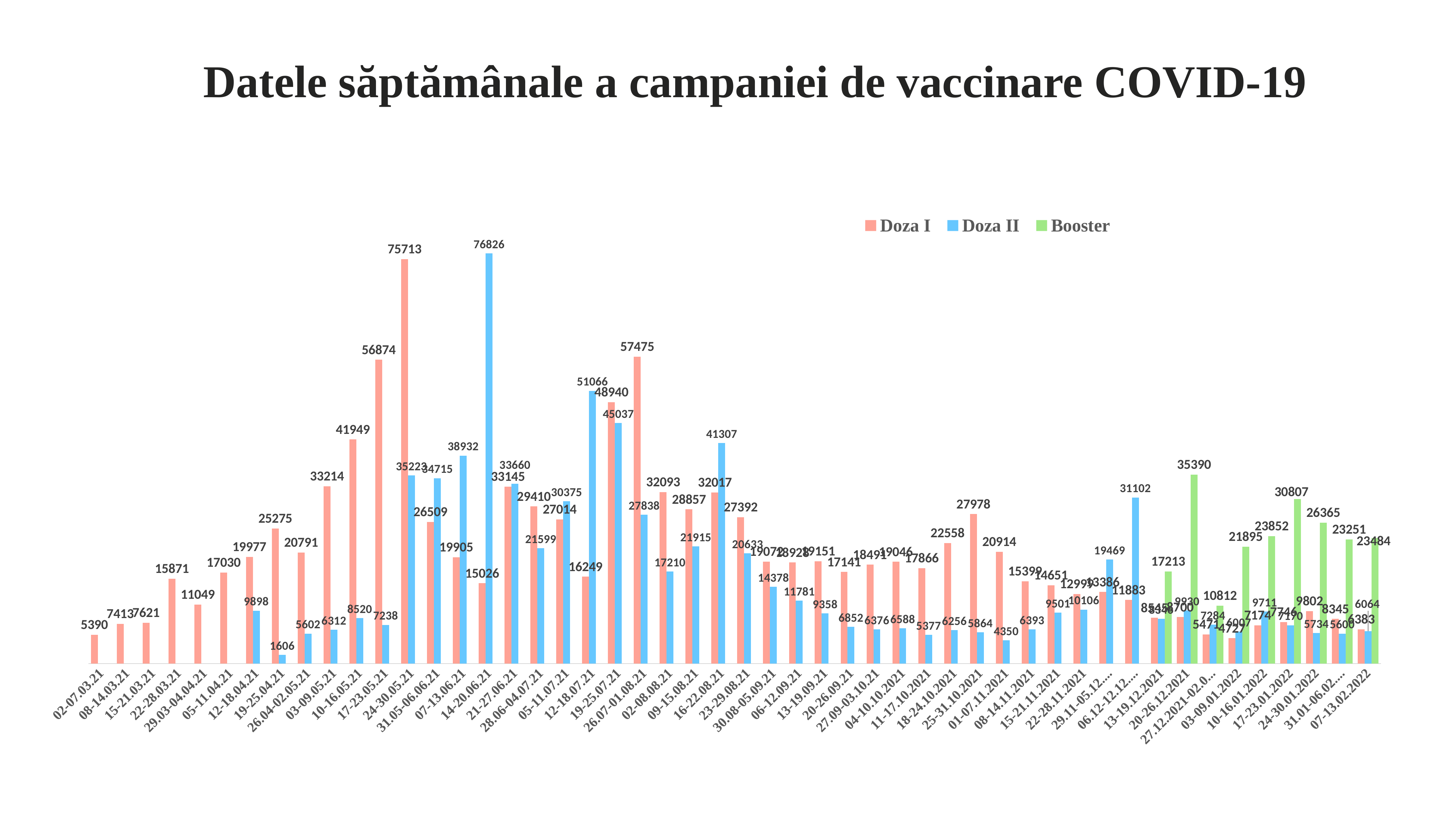
What is the difference between Doza I and Doza II in the week 24-30.05.21? 40490 What is the Booster value for the week 17-23.01.2022? 30807 In which week is the Doza II value lowest? 19-25.04.21 What is the Doza II value for the week 14-20.06.21? 76826 In the week 19-25.07.21, which is larger: Doza I or Doza II? Doza I In which week is the Booster value highest? 20-26.12.2021 What colour represents the Booster series in the legend? Green What kind of chart is shown on the slide? Bar chart What is the Doza I value for the week 17-23.05.21? 56874 What is the Doza I value for the week 24-30.05.21? 75713 How many series does the legend list? 3 What is the Doza II value for the week 16-22.08.21? 41307